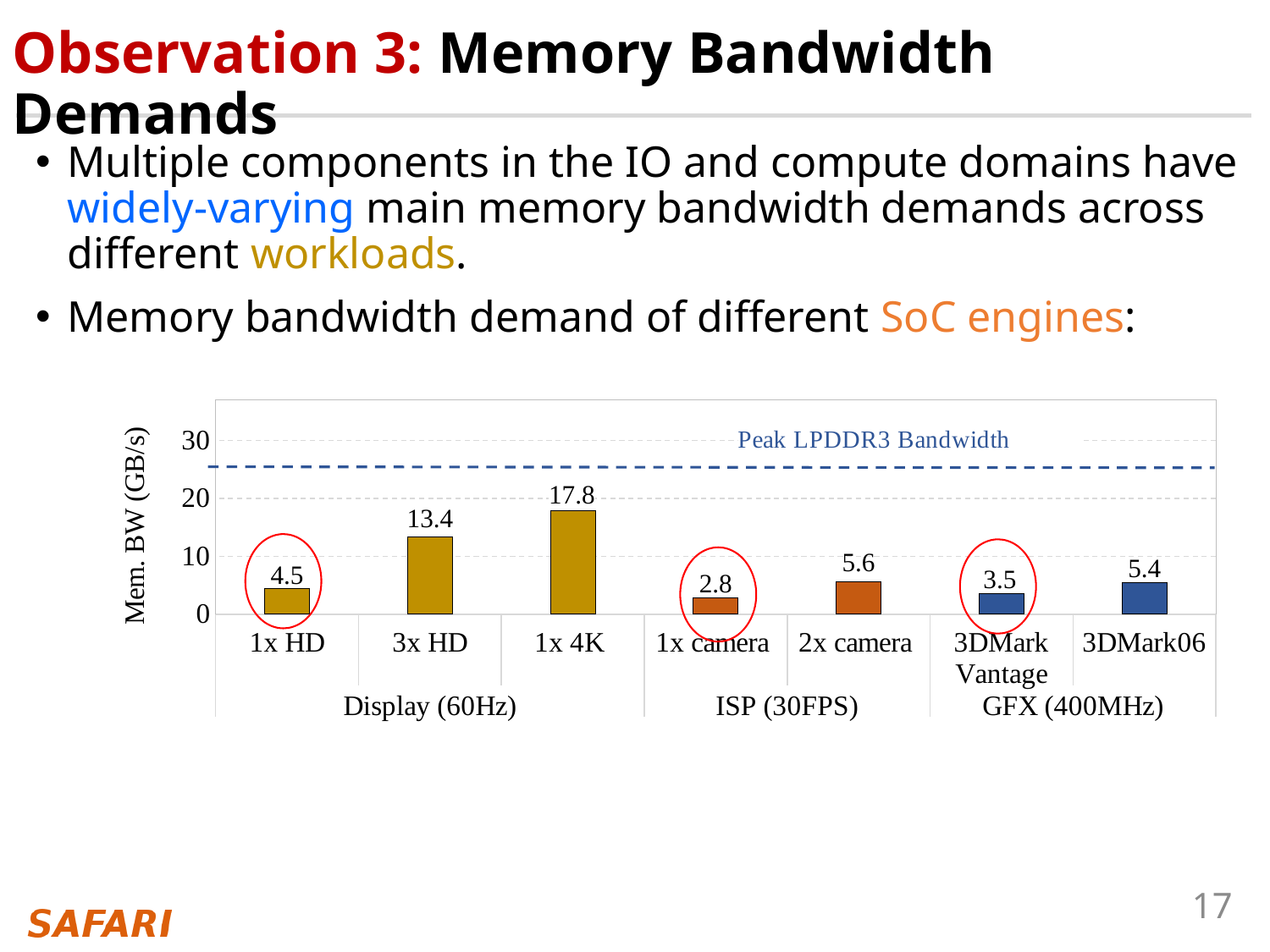
Is the value for 1x 4K greater or less than 20? less What is the memory bandwidth value for 3DMark Vantage? 3.5 Which category has the highest memory bandwidth demand? 1x 4K What is the difference between the values for 3x HD and 1x HD? 8.9 What is the memory bandwidth value for 1x 4K? 17.8 Which is larger, the value for 3DMark06 or the value for 2x camera? 2x camera What is the label of the y axis? Mem. BW (GB/s) What kind of chart is shown on the slide? bar chart How many categories are plotted in the chart? 7 What is the memory bandwidth value for 2x camera? 5.6 What does the dashed horizontal line in the chart represent? Peak LPDDR3 Bandwidth Which category has the lowest memory bandwidth demand? 1x camera